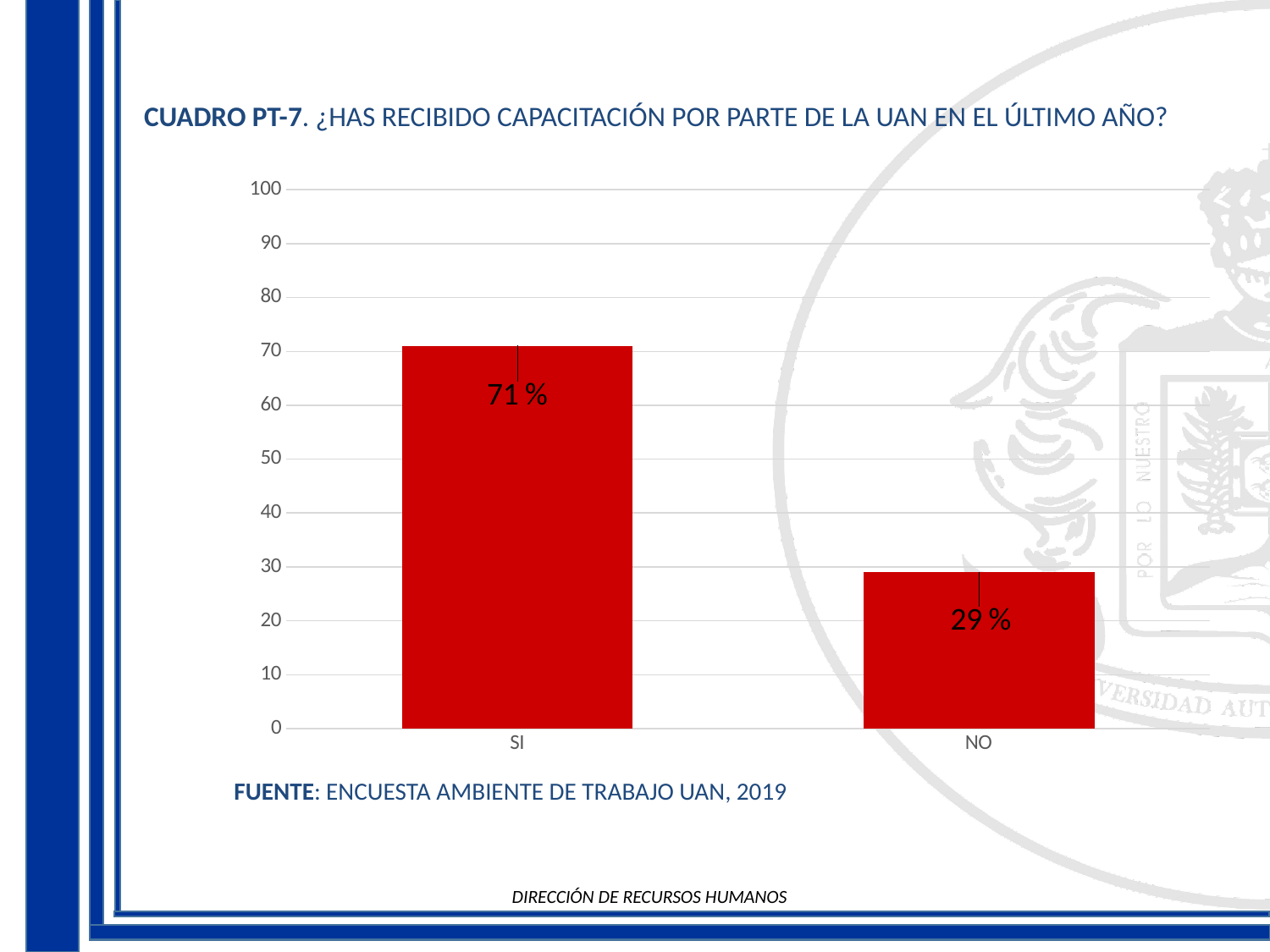
What is the maximum value shown on the y axis? 100 What kind of chart is shown on the slide? bar chart Which category has the lowest value? NO Is the value for SI greater or less than 60? greater Is the value for NO greater or less than 30? less What is the value for NO? 29 % How many categories are shown on the x axis? 2 What is the value for SI? 71 % What colour are the bars in the chart? red Which is larger, the value for SI or the value for NO? SI What is the difference between the values for SI and NO? 42 % Which category has the highest value? SI